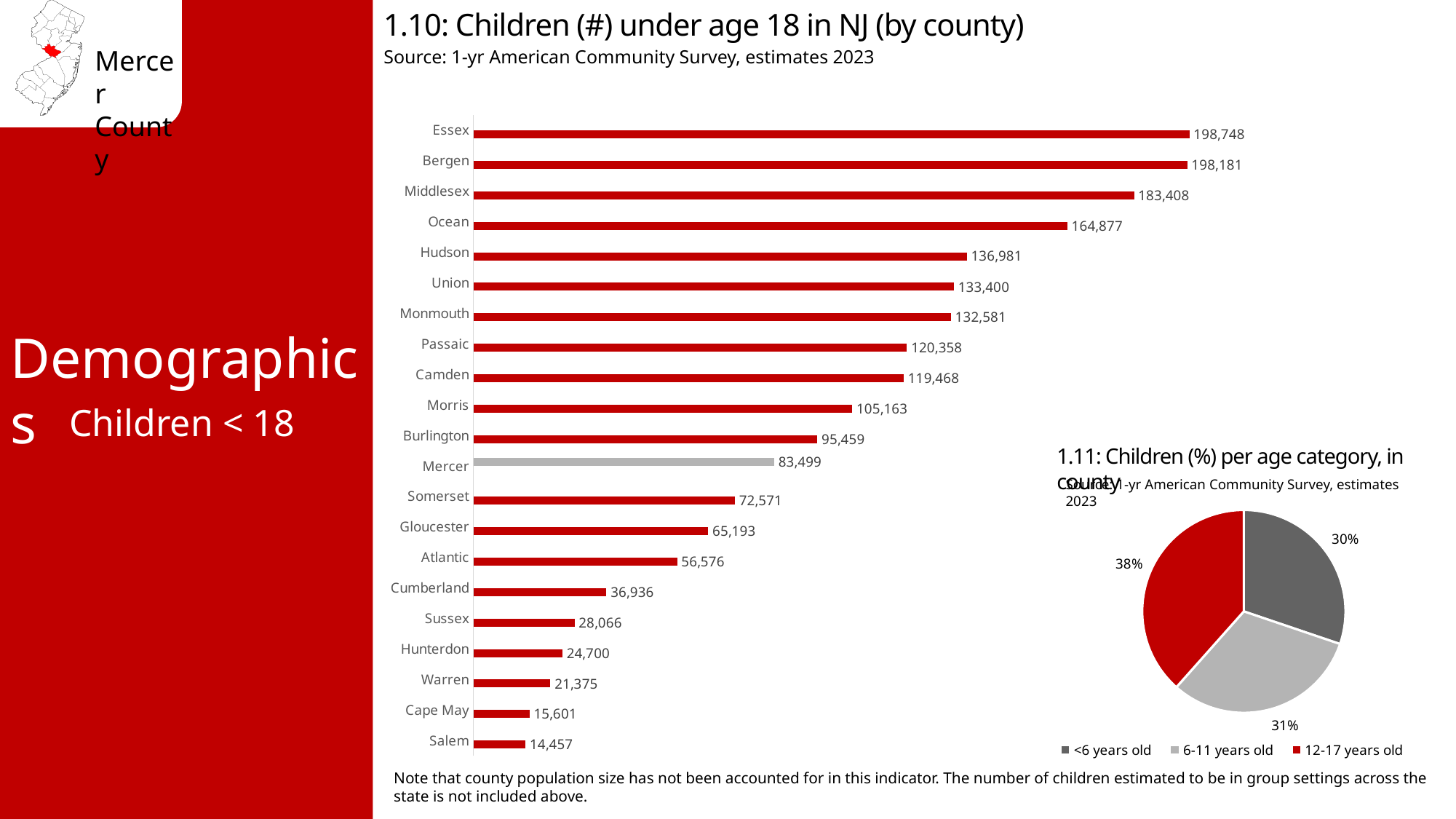
How many categories does the legend of chart 1.11 list? 3 In chart 1.10, how many counties are shown? 21 In chart 1.10, which is larger, the value for Hudson or the value for Passaic? Hudson In chart 1.10, what is the value for Ocean? 164,877 In chart 1.10 (Children under age 18 in NJ by county), what is the value for Mercer? 83,499 In chart 1.11, which age category has the smallest share? <6 years old In chart 1.11 (Children (%) per age category, in county), what share of children are 12-17 years old? 38% In chart 1.10, which county has the lowest number of children under 18? Salem In chart 1.10, which county's bar is coloured grey instead of red? Mercer In chart 1.10, which county has the highest number of children under 18? Essex What kind of chart is chart 1.10? Bar chart In chart 1.10, what is the difference between the values for Essex and Mercer? 115,249